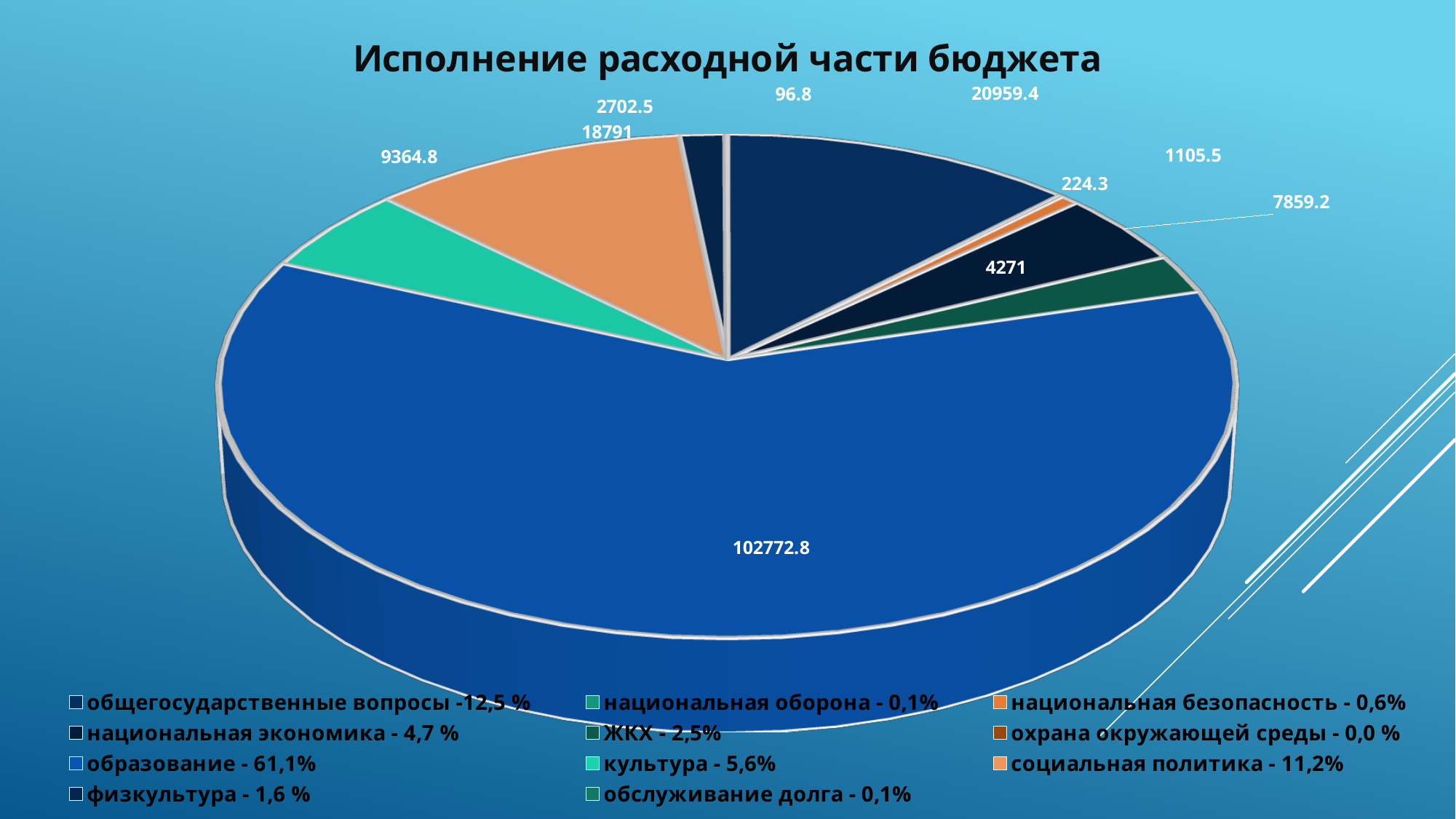
What value is shown for культура? 9364.8 What share of the pie does социальная политика account for, according to the legend? 11,2% What type of chart is shown on the slide? pie chart What is the difference between the values for общегосударственные вопросы and социальная политика? 2168.4 Which category has the largest slice of the pie? образование What is the title of the chart? Исполнение расходной части бюджета How many categories does the legend list? 11 What value is shown for социальная политика? 18791 What share of the pie does образование account for, according to the legend? 61,1% What value is shown for ЖКХ? 4271 What value is shown for образование? 102772.8 Which is larger, the value for культура or the value for национальная экономика? культура